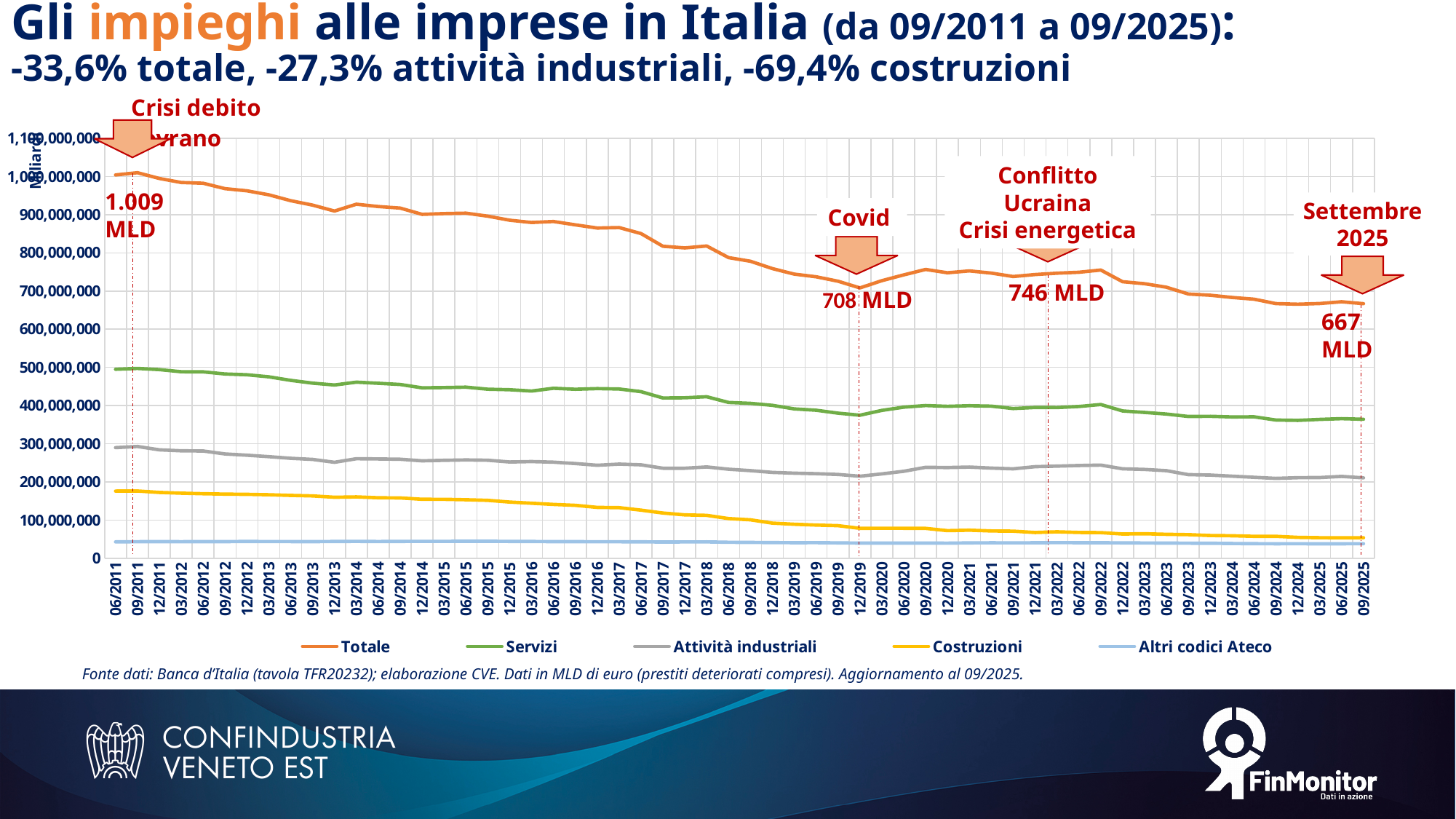
What is the difference between the annotated Totale values at 03/2022 and 12/2019? 38 MLD At 09/2025, which is larger: Servizi or Attività industriali? Servizi How many series does the legend list? 5 Which series has the lowest values throughout the chart? Altri codici Ateco What is the value of Totale at 09/2011 according to the annotation? 1.009 MLD What is the value of Totale at 03/2022 according to the annotation? 746 MLD What kind of chart is shown on the slide? line chart What is the difference between the annotated Totale values at 09/2011 and 09/2025? 342 MLD What is the value of Totale at 09/2025 according to the annotation? 667 MLD Is the value for Servizi at 09/2025 greater or less than 400,000,000? less What is the value of Totale at 12/2019 (Covid) according to the annotation? 708 MLD Does the Totale series rise or fall from 06/2011 to 09/2025? fall